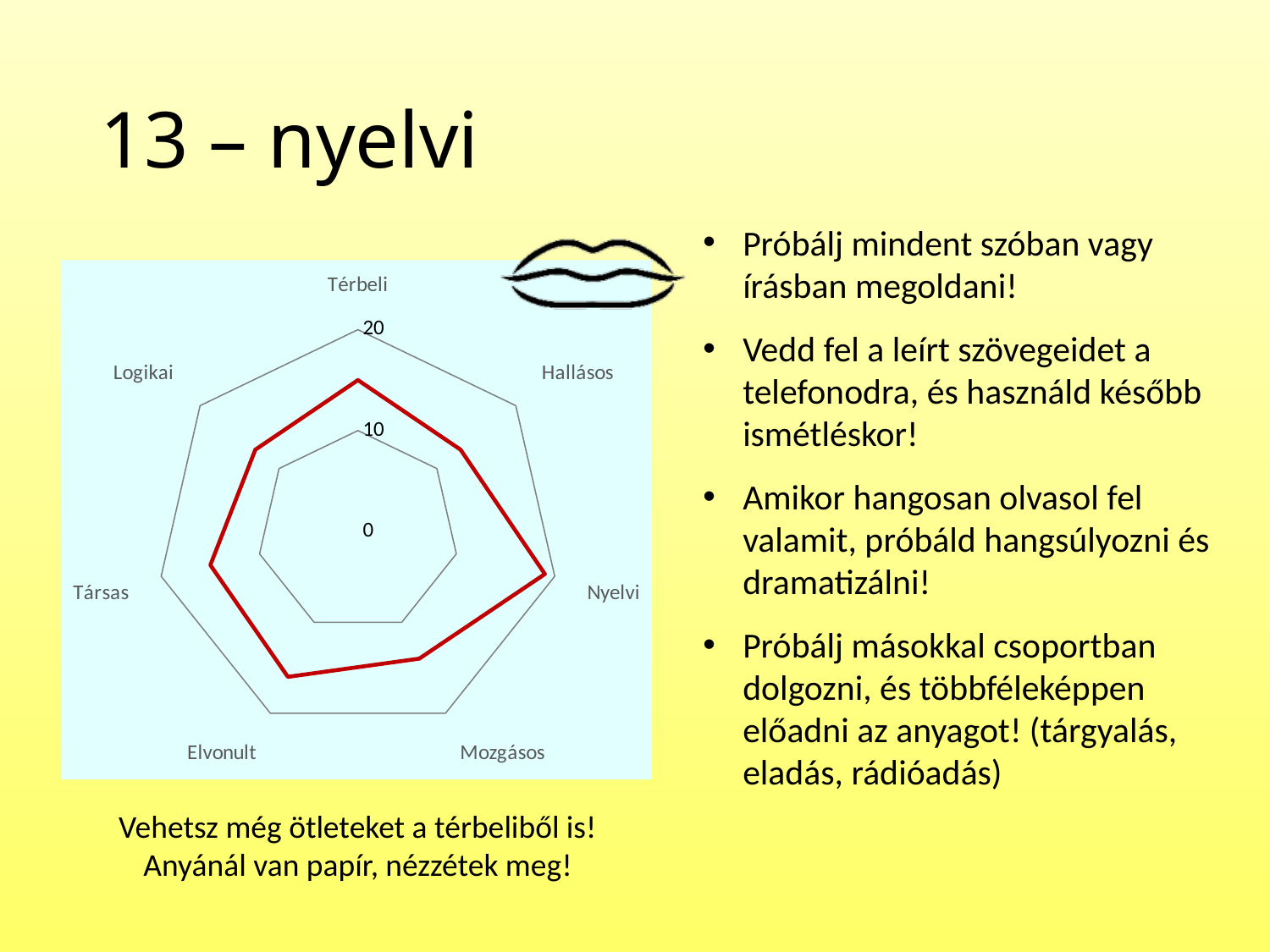
How many categories (axes) does the radar chart have? 7 Is the value for Térbeli greater or less than 10? greater Is the value for Logikai greater or less than 20? less Is the value for Társas greater or less than 20? less What kind of chart is shown on the slide? Radar chart What is the maximum value shown on the radar chart's axis scale? 20 Which is larger, the value for Elvonult or the value for Logikai? Elvonult Which category has the highest value on the radar chart? Nyelvi Which category label appears at the top of the radar chart? Térbeli Which is larger, the value for Nyelvi or the value for Hallásos? Nyelvi